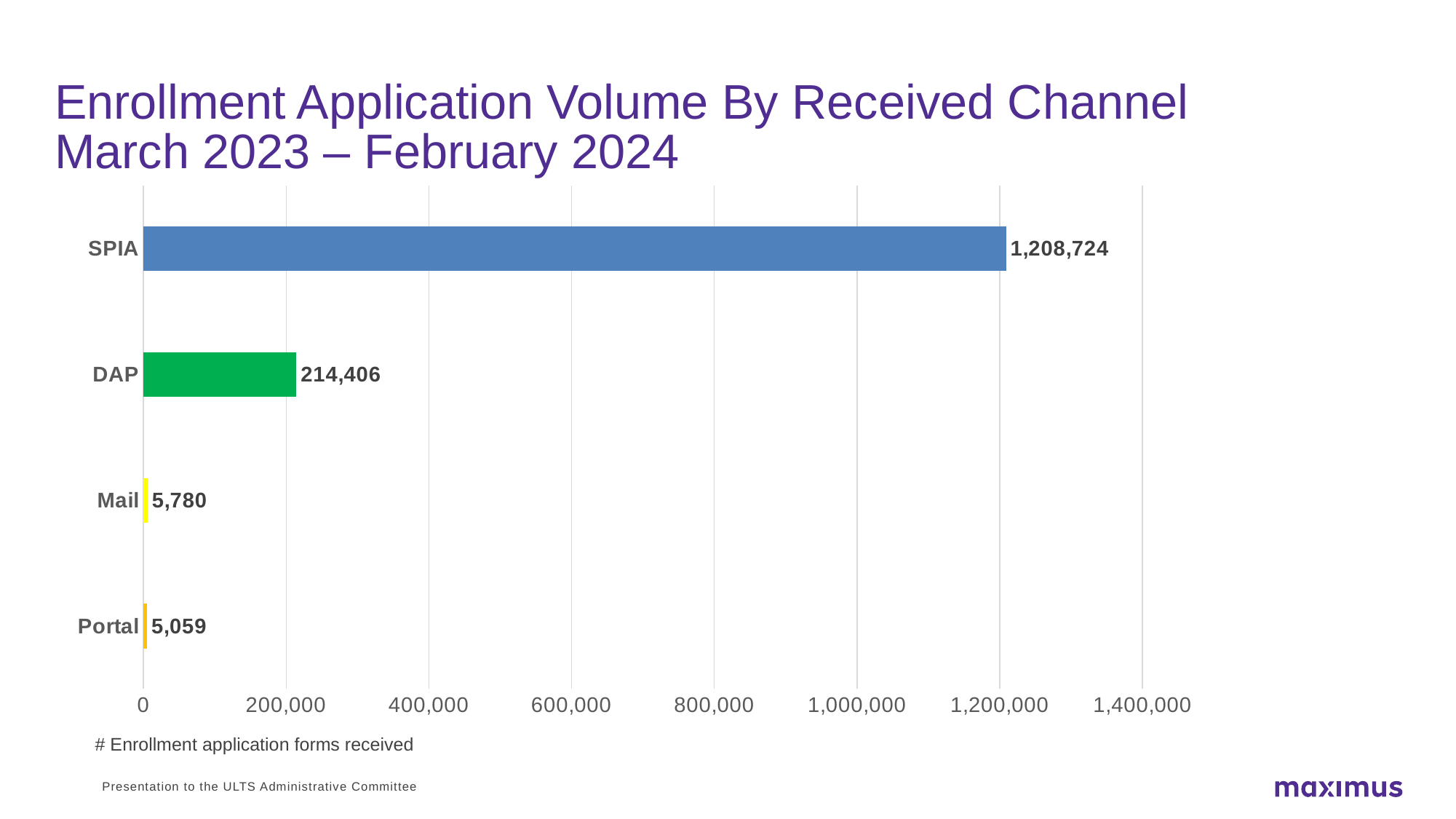
Which channel has the highest enrollment application volume? SPIA What is the value for Mail? 5,780 What kind of chart is shown on the slide? Bar chart How many channels are shown in the chart? 4 Which channel has the lowest enrollment application volume? Portal What is the value for DAP? 214,406 What is the value for Portal? 5,059 Which is larger, the value for Mail or the value for Portal? Mail What is the difference between the values for SPIA and DAP? 994,318 Is the value for DAP greater or less than 200,000? greater What is the difference between the values for Mail and Portal? 721 What is the value for SPIA? 1,208,724